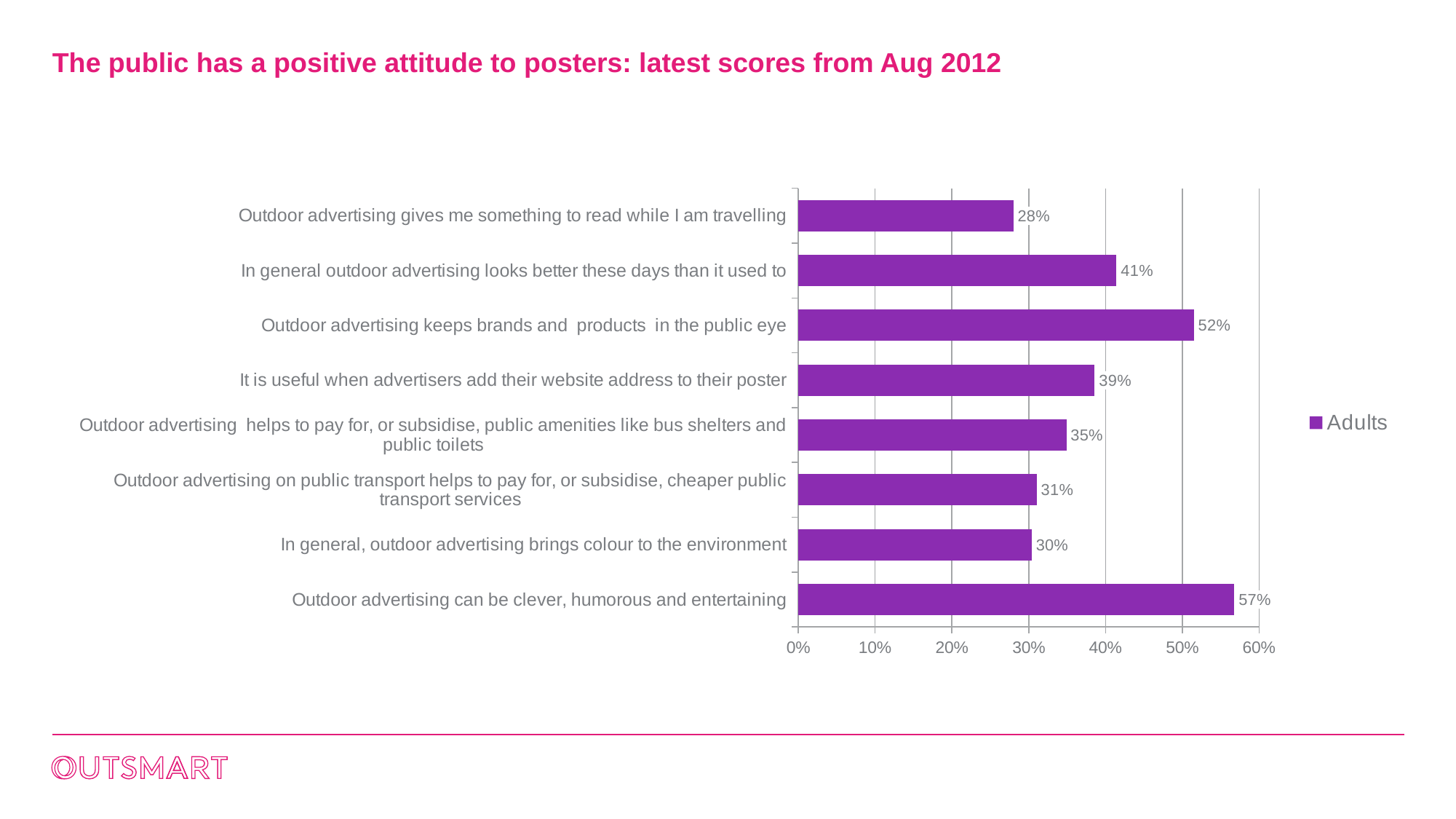
What is the value for 'In general, outdoor advertising brings colour to the environment'? 30% What percentage of adults agree that outdoor advertising can be clever, humorous and entertaining? 57% Which has a higher score: 'In general outdoor advertising looks better these days than it used to' or 'It is useful when advertisers add their website address to their poster'? In general outdoor advertising looks better these days than it used to What is the difference between the scores for 'Outdoor advertising can be clever, humorous and entertaining' and 'Outdoor advertising keeps brands and products in the public eye'? 5% Is the value for 'Outdoor advertising helps to pay for, or subsidise, public amenities like bus shelters and public toilets' greater or less than 40%? less Which statement has the lowest score? Outdoor advertising gives me something to read while I am travelling Which statement has the highest score? Outdoor advertising can be clever, humorous and entertaining How many statements are shown in the chart? 8 What percentage of adults agree that outdoor advertising gives them something to read while travelling? 28% What is the value for 'Outdoor advertising keeps brands and products in the public eye'? 52% How many series does the legend list? 1 What kind of chart is shown on the slide? Bar chart